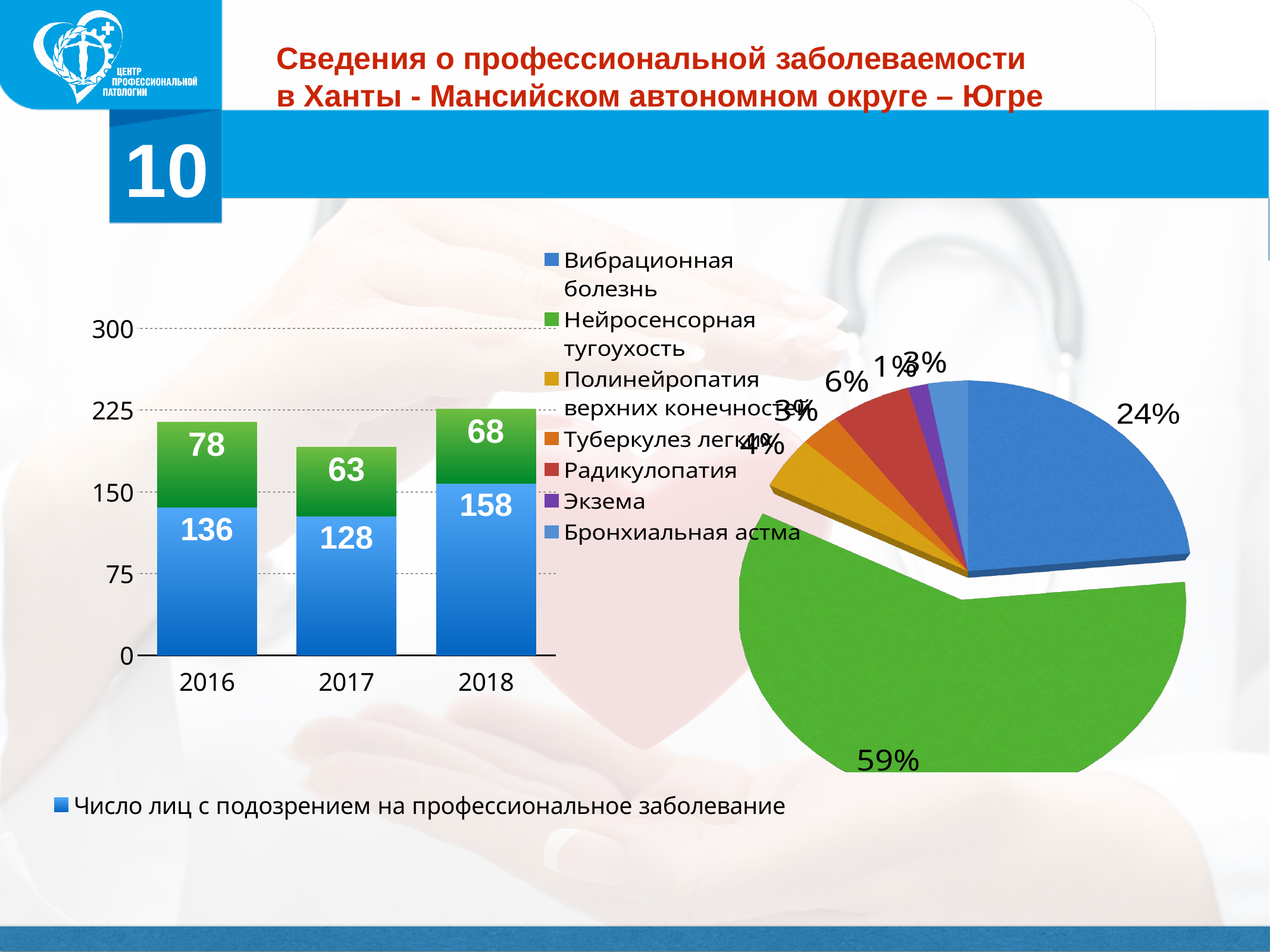
In the bar chart on the left, which year has the highest value for the blue series (Число лиц с подозрением на профессиональное заболевание)? 2018 In the bar chart on the left, what is the total of the stacked bar for 2016? 214 What kind of chart is the chart on the left of the slide? Stacked bar chart In the bar chart on the left, what is the difference between the blue series values for 2018 and 2017? 30 In the bar chart on the left, what is the value of the blue series (Число лиц с подозрением на профессиональное заболевание) for 2018? 158 In the pie chart on the right, what share does Нейросенсорная тугоухость have? 59% In the bar chart on the left, which year has the lowest value for the green segment? 2017 In the bar chart on the left, how many years are shown on the x axis? 3 In the bar chart on the left, what is the value of the blue series (Число лиц с подозрением на профессиональное заболевание) for 2017? 128 In the pie chart on the right, what share does Вибрационная болезнь have? 24% In the bar chart on the left, what is the value of the green segment for 2016? 78 In the pie chart on the right, how many categories does the legend list? 7